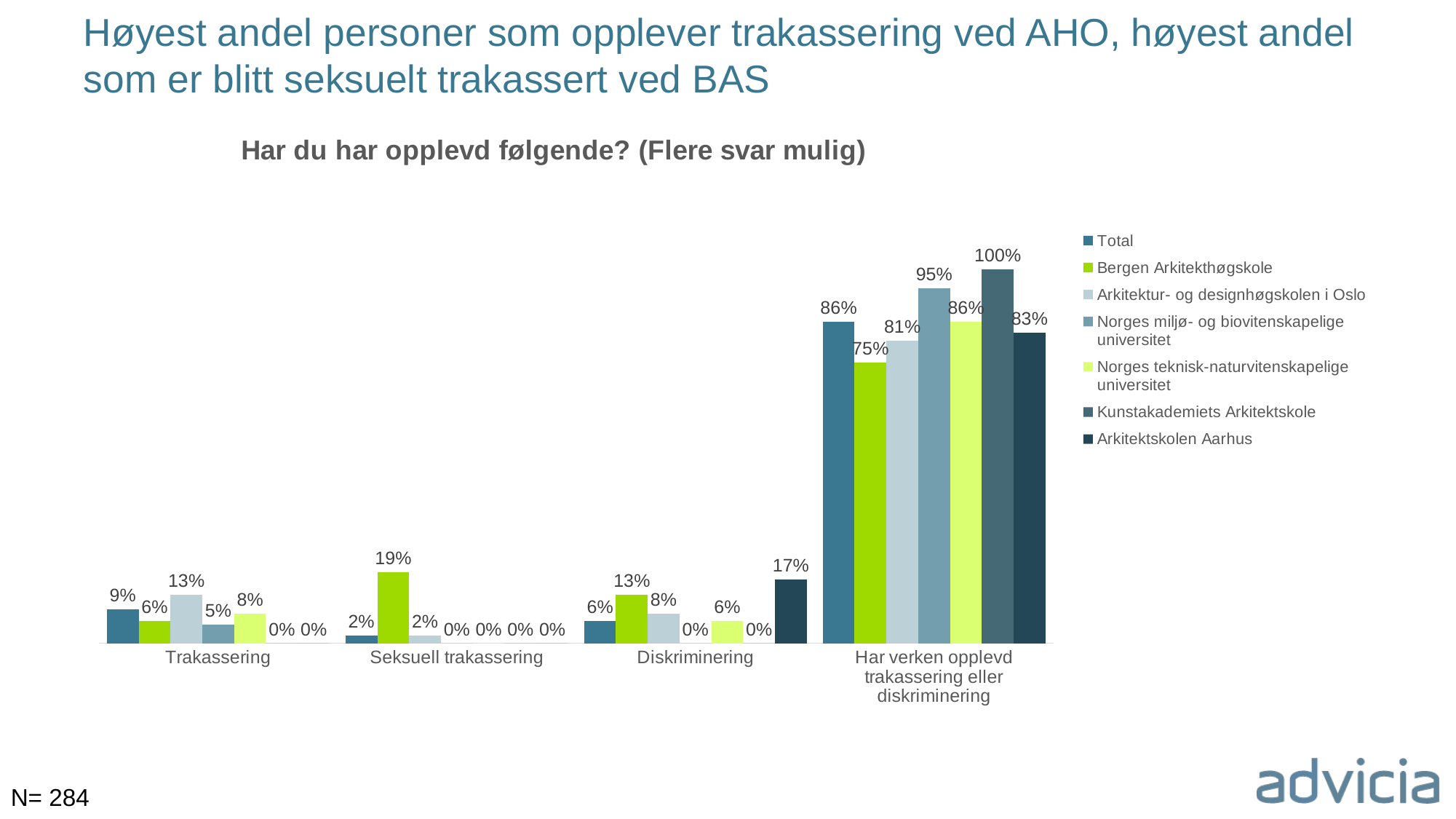
What is the title of the chart? Har du har opplevd følgende? (Flere svar mulig) In the Diskriminering category, which is larger: the value for Bergen Arkitekthøgskole or the value for Arkitektskolen Aarhus? Arkitektskolen Aarhus What is the value for Arkitektur- og designhøgskolen i Oslo in the Trakassering category? 13% Which series has the highest value in the Har verken opplevd trakassering eller diskriminering category? Kunstakademiets Arkitektskole Which series has the lowest value in the Har verken opplevd trakassering eller diskriminering category? Bergen Arkitekthøgskole What is the difference between the Norges miljø- og biovitenskapelige universitet value and the Bergen Arkitekthøgskole value in the Har verken opplevd trakassering eller diskriminering category? 20% What kind of chart is shown on the slide? Bar chart What is the value for Bergen Arkitekthøgskole in the Seksuell trakassering category? 19% What is the value for Arkitektskolen Aarhus in the Diskriminering category? 17% How many series does the legend list? 7 How many categories are shown on the x axis? 4 What is the Total value for Har verken opplevd trakassering eller diskriminering? 86%